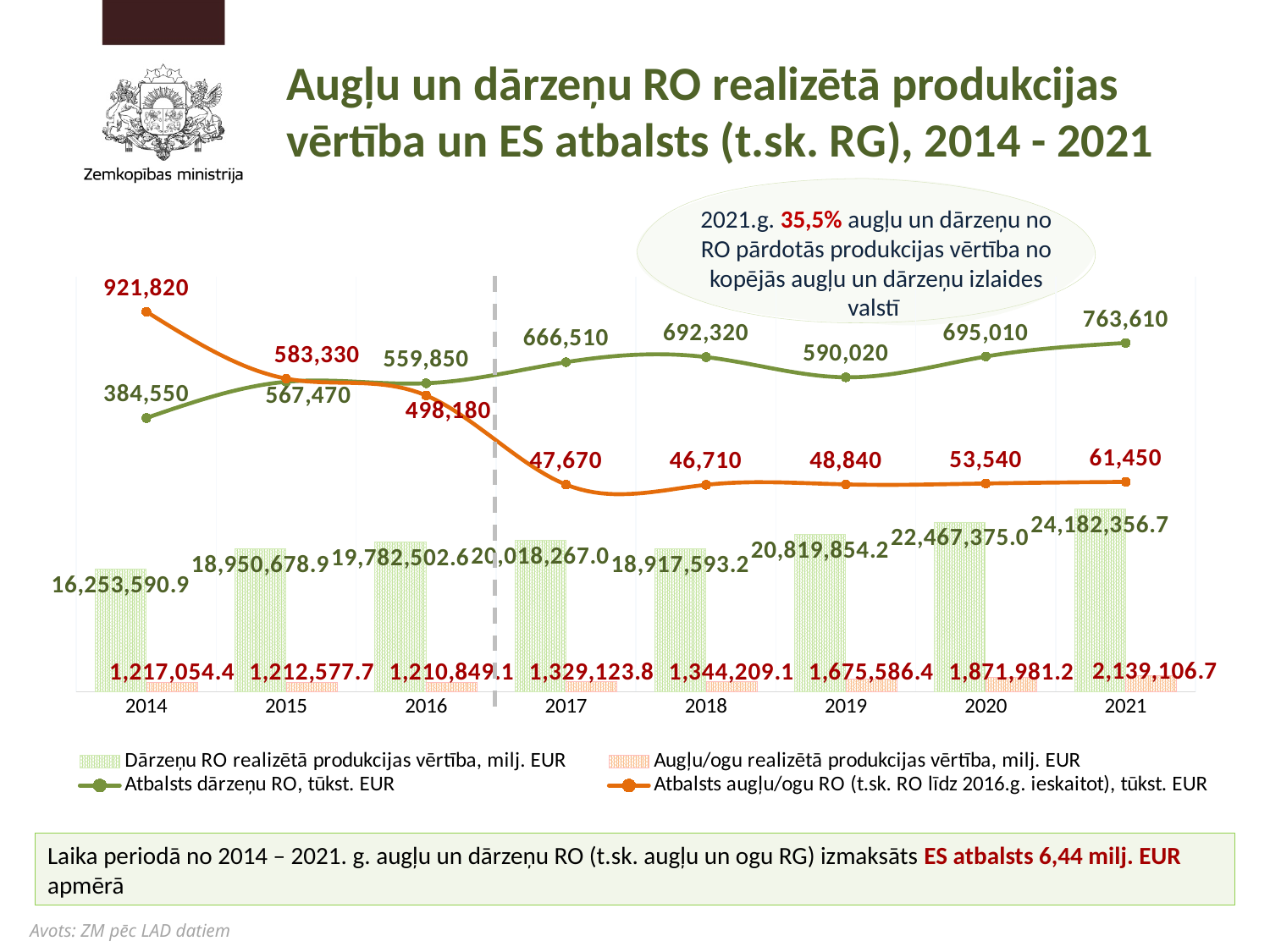
How many series does the legend list? 4 What is the value of 'Augļu/ogu realizētā produkcijas vērtība, milj. EUR' in 2021? 2,139,106.7 What is the value of 'Dārzeņu RO realizētā produkcijas vērtība, milj. EUR' in 2019? 20,819,854.2 What kind of chart is shown on the slide? Combined bar and line chart In which year is 'Atbalsts augļu/ogu RO' lowest? 2018 Does 'Augļu/ogu realizētā produkcijas vērtība' rise or fall from 2016 to 2021? Rise What is the value of 'Atbalsts dārzeņu RO, tūkst. EUR' in 2021? 763,610 How many years are shown on the x axis? 8 What is the value of 'Atbalsts augļu/ogu RO' in 2014? 921,820 What is the difference between 'Atbalsts dārzeņu RO' in 2021 and in 2014? 379,060 In which year is 'Dārzeņu RO realizētā produkcijas vērtība' highest? 2021 Which is larger in 2015: 'Atbalsts dārzeņu RO' or 'Atbalsts augļu/ogu RO'? Atbalsts augļu/ogu RO